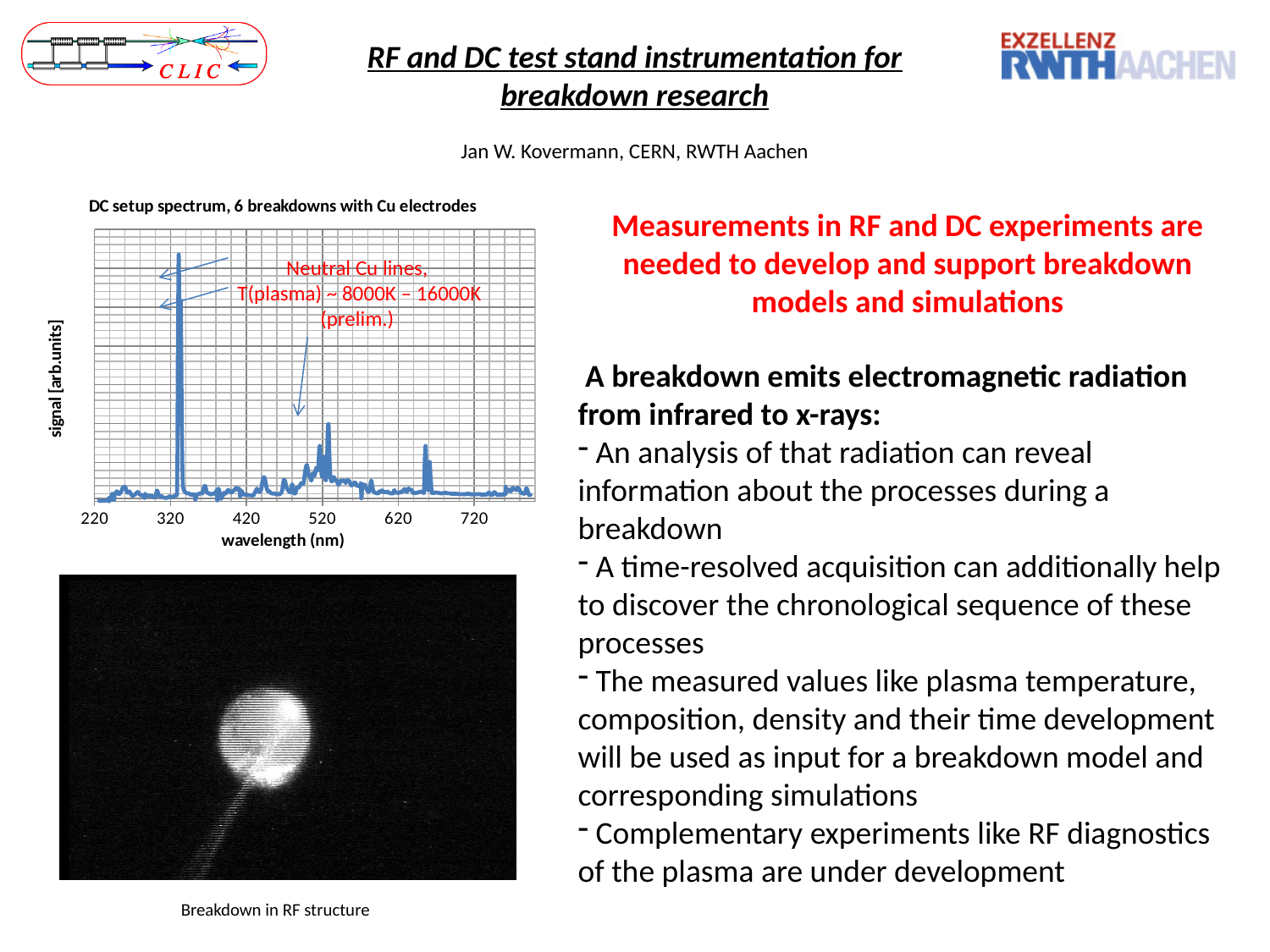
What kind of chart is shown on the slide? line chart What is the highest wavelength value labelled on the x axis of the chart? 720 Is the wavelength of the small peak on the right side of the spectrum greater or less than 720 nm? less What is the title of the chart on the slide? DC setup spectrum, 6 breakdowns with Cu electrodes Which is larger: the signal of the tallest peak near 320 nm or the signal of the peak near 520 nm? the peak near 320 nm Is the wavelength of the small peak on the right side of the spectrum greater or less than 620 nm? greater What is the label of the x axis of the chart? wavelength (nm) Is the wavelength of the tallest peak in the spectrum greater or less than 420 nm? less What is the lowest wavelength value labelled on the x axis of the chart? 220 How many labelled tick marks are shown on the x axis of the chart? 6